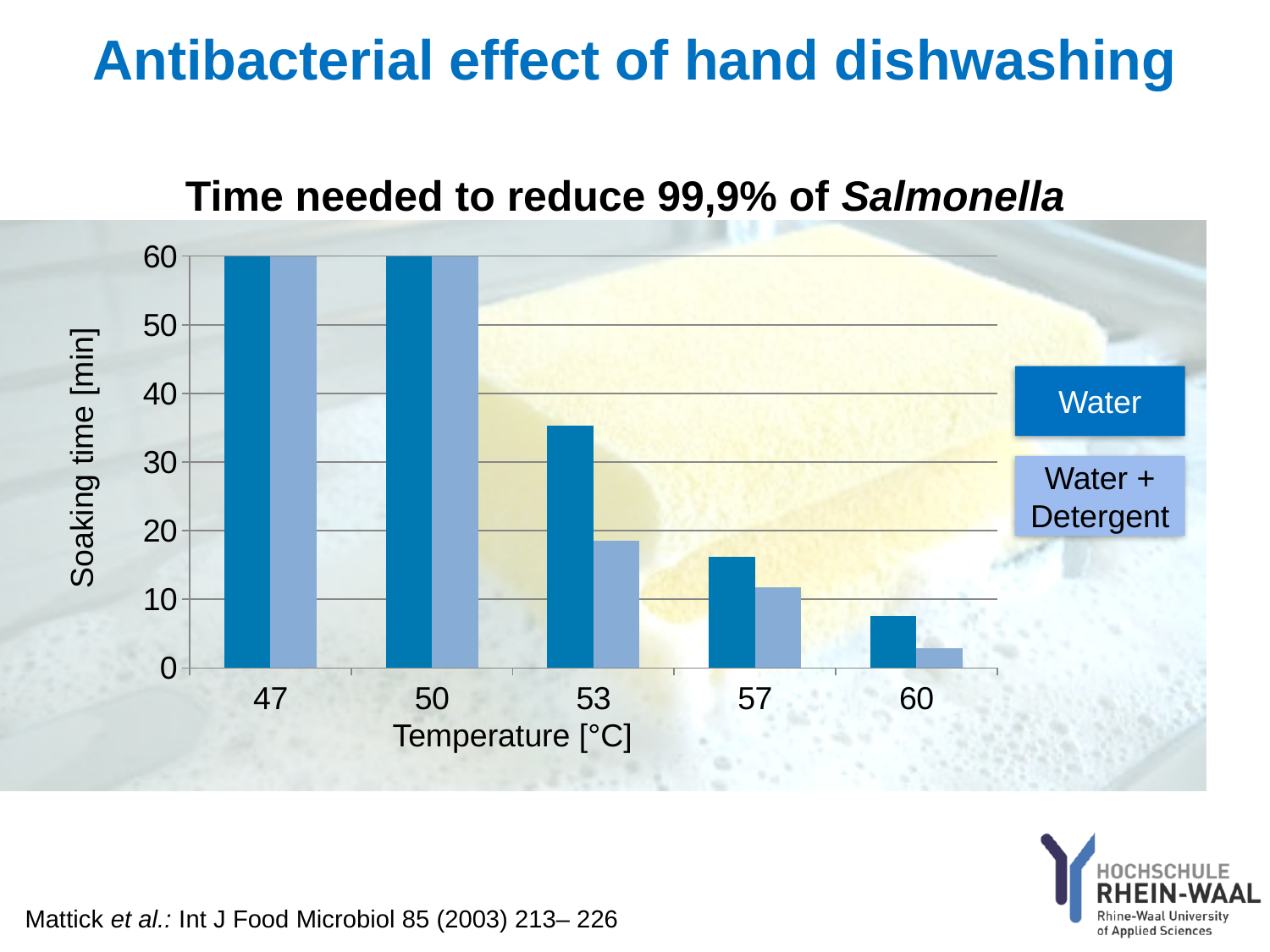
What kind of chart is shown on the slide? bar chart What is the label of the y axis? Soaking time [min] Is the value for Water + Detergent at 53 °C greater or less than 20? less What is the soaking time for Water + Detergent at 50 °C? 60 Which temperature has the lowest soaking time for Water + Detergent? 60 Do the soaking times rise or fall as temperature increases along the x axis? fall What is the soaking time for Water at 47 °C? 60 Is the value for Water at 53 °C greater or less than 30? greater At 57 °C, which series has the larger soaking time, Water or Water + Detergent? Water Is the value for Water at 60 °C greater or less than 10? less How many series does the legend list? 2 How many temperature categories are shown on the x axis? 5